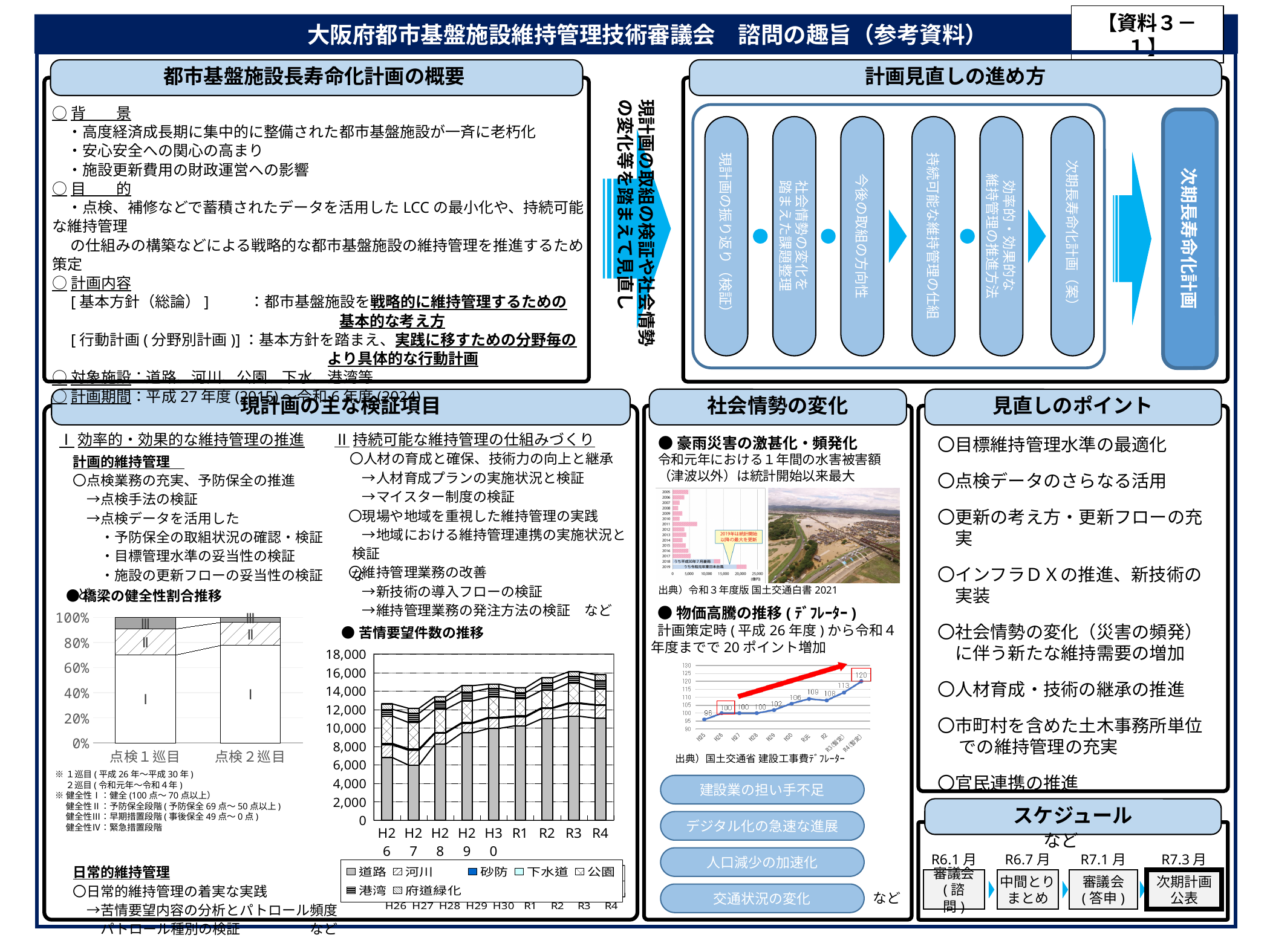
How many series does the legend of the 苦情要望件数の推移 chart list? 7 In the 物価高騰の推移 (デフレーター) chart, which point has the highest value? R4(暫定) In the 物価高騰の推移 (デフレーター) chart, which point has the lowest value? H25 In the 物価高騰の推移 (デフレーター) chart, what is the value for H25? 96 How many data points are plotted in the 物価高騰の推移 (デフレーター) chart? 10 In the 物価高騰の推移 (デフレーター) chart, what is the difference between the R4(暫定) value and the H25 value? 24 In the 物価高騰の推移 (デフレーター) chart, what is the value for H30? 106 In the 物価高騰の推移 (デフレーター) chart, what is the value for R4(暫定)? 120 In the 苦情要望件数の推移 chart, is the total for R4 greater or less than 14,000? greater How many categories are shown on the x axis of the 苦情要望件数の推移 chart? 9 What kind of chart is the 橋梁の健全性割合推移 chart? bar chart In the 物価高騰の推移 (デフレーター) chart, which is larger, the value for R1 or the value for R2? R1